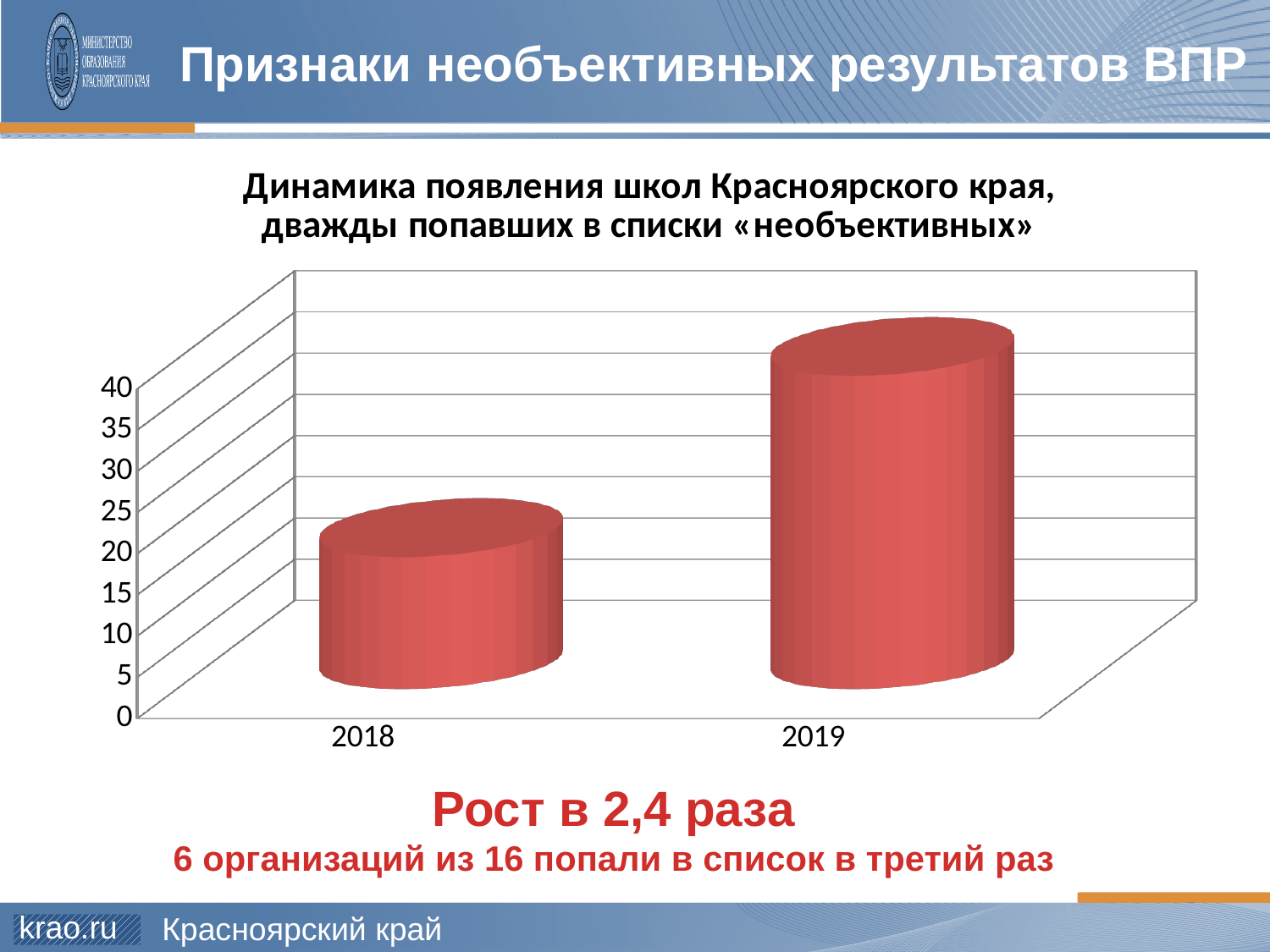
What colour are the bars in the chart? red Is the value for 2019 greater or less than 30? greater Which year has the higher value in the chart? 2019 Which year has the lower value in the chart? 2018 Do the values rise or fall from 2018 to 2019? rise What is the highest tick value shown on the vertical axis of the chart? 40 What kind of chart is shown on the slide? bar chart Is the value for 2018 greater or less than 10? greater Is the value for 2018 greater or less than 25? less How many categories are plotted on the x axis of the chart? 2 Is the value for 2019 larger or smaller than the value for 2018? larger